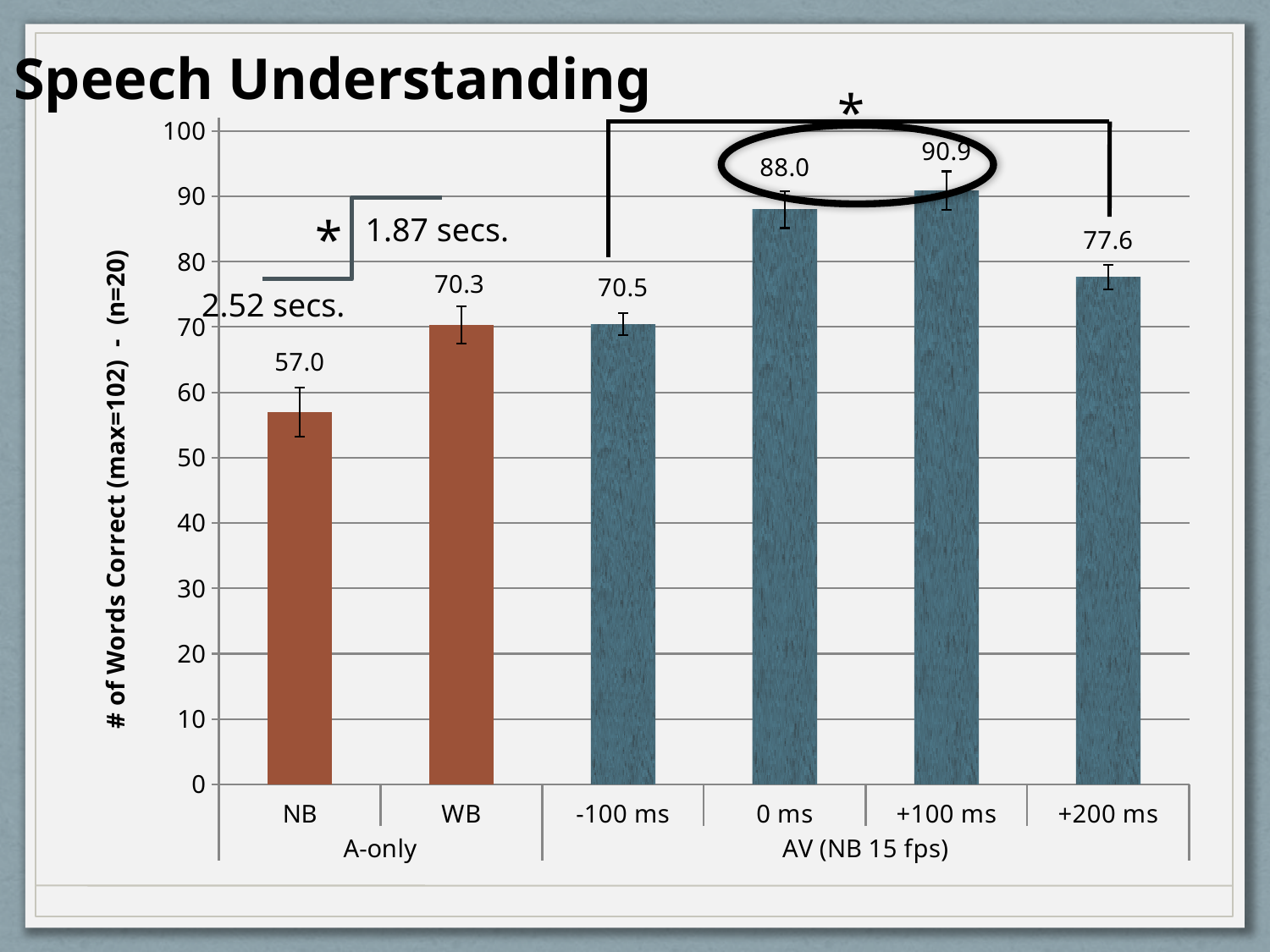
What is the difference between the +100 ms and +200 ms values? 13.3 Which is larger, the value for 0 ms or the value for +200 ms? 0 ms What kind of chart is shown on the slide? bar chart What is the title of the slide? Speech Understanding What is the value for the +100 ms condition? 90.9 What is the y-axis label of the chart? # of Words Correct (max=102) - (n=20) What is the value for the 0 ms condition? 88.0 Which category has the lowest number of words correct? NB What is the difference between the WB and NB values in the A-only condition? 13.3 How many bars are plotted in the chart? 6 Which category has the highest number of words correct? +100 ms What is the value for NB in the A-only condition? 57.0